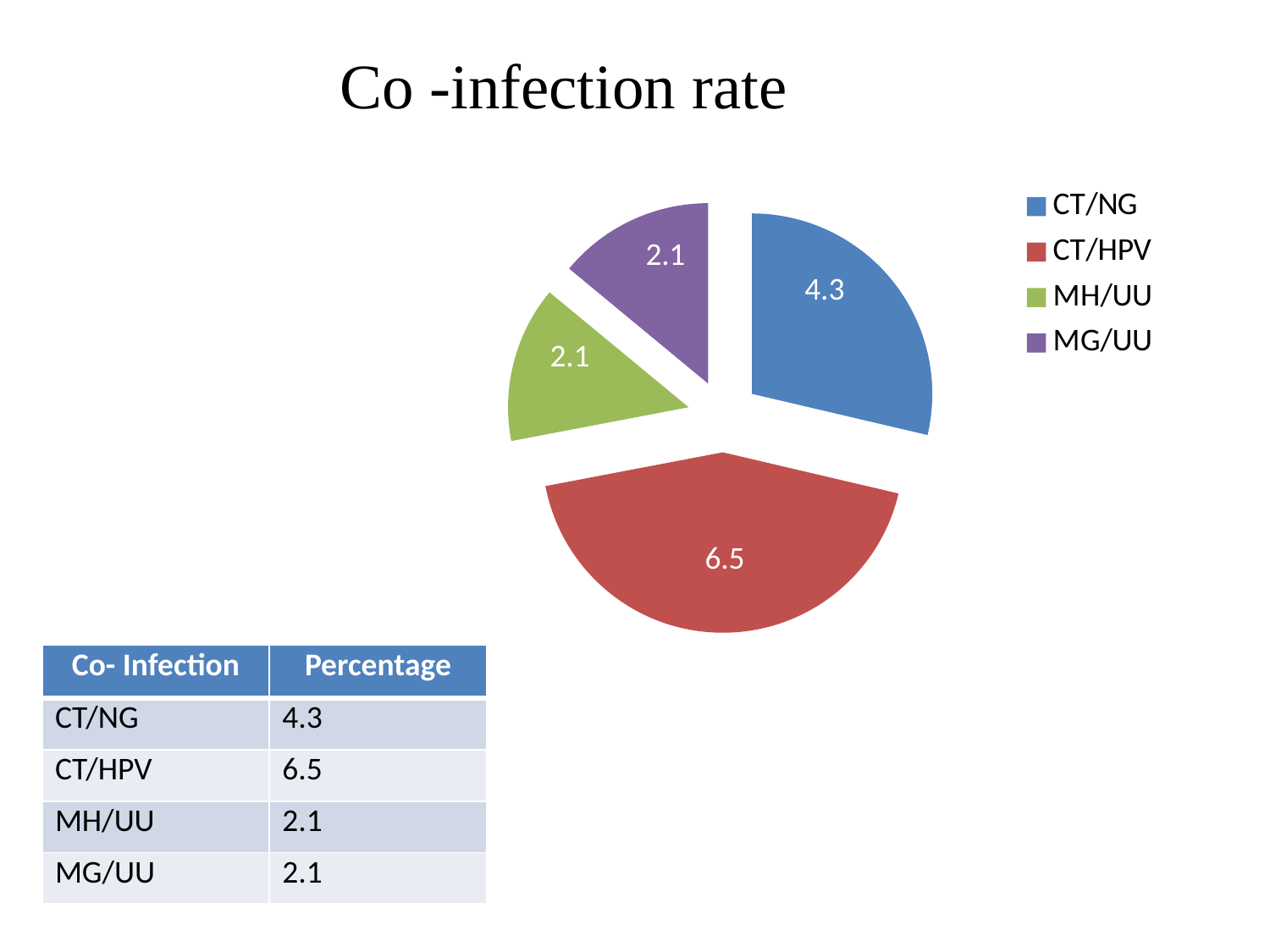
What share of the pie chart does the MH/UU slice represent? 14% What colour is the CT/HPV slice in the pie chart? Red What is the value of the CT/NG slice in the pie chart? 4.3 What is the value of the CT/HPV slice in the pie chart? 6.5 What is the value of the MH/UU slice in the pie chart? 2.1 What type of chart is shown on the slide? Pie chart How many slices does the pie chart have? 4 What is the difference between the CT/HPV and CT/NG values in the pie chart? 2.2 Which co-infection has the largest slice in the pie chart? CT/HPV Which is larger in the pie chart, CT/NG or MH/UU? CT/NG What is the total of all the slice values in the pie chart? 15.0 What is the value of the MG/UU slice in the pie chart? 2.1